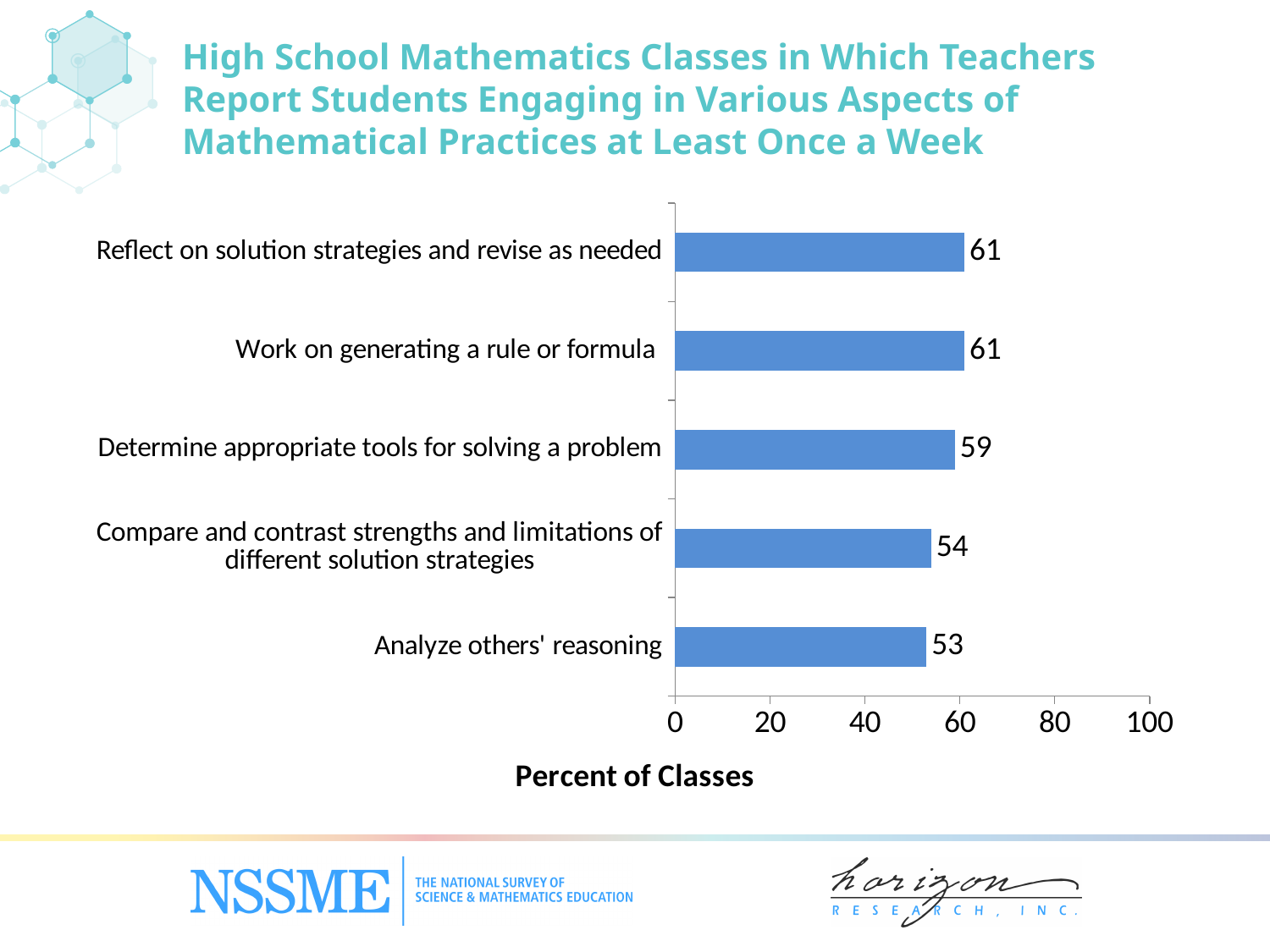
What is the value for "Analyze others' reasoning"? 53 What is the label of the horizontal axis? Percent of Classes Which is larger: the value for "Determine appropriate tools for solving a problem" or the value for "Analyze others' reasoning"? Determine appropriate tools for solving a problem Which category has the lowest value? Analyze others' reasoning What is the value for "Work on generating a rule or formula"? 61 Is the value for "Compare and contrast strengths and limitations of different solution strategies" greater or less than 60? less How many categories are shown in the chart? 5 What is the value for "Determine appropriate tools for solving a problem"? 59 What is the value for "Compare and contrast strengths and limitations of different solution strategies"? 54 What kind of chart is shown on the slide? bar chart What is the difference between the values for "Reflect on solution strategies and revise as needed" and "Analyze others' reasoning"? 8 What is the difference between the values for "Determine appropriate tools for solving a problem" and "Compare and contrast strengths and limitations of different solution strategies"? 5